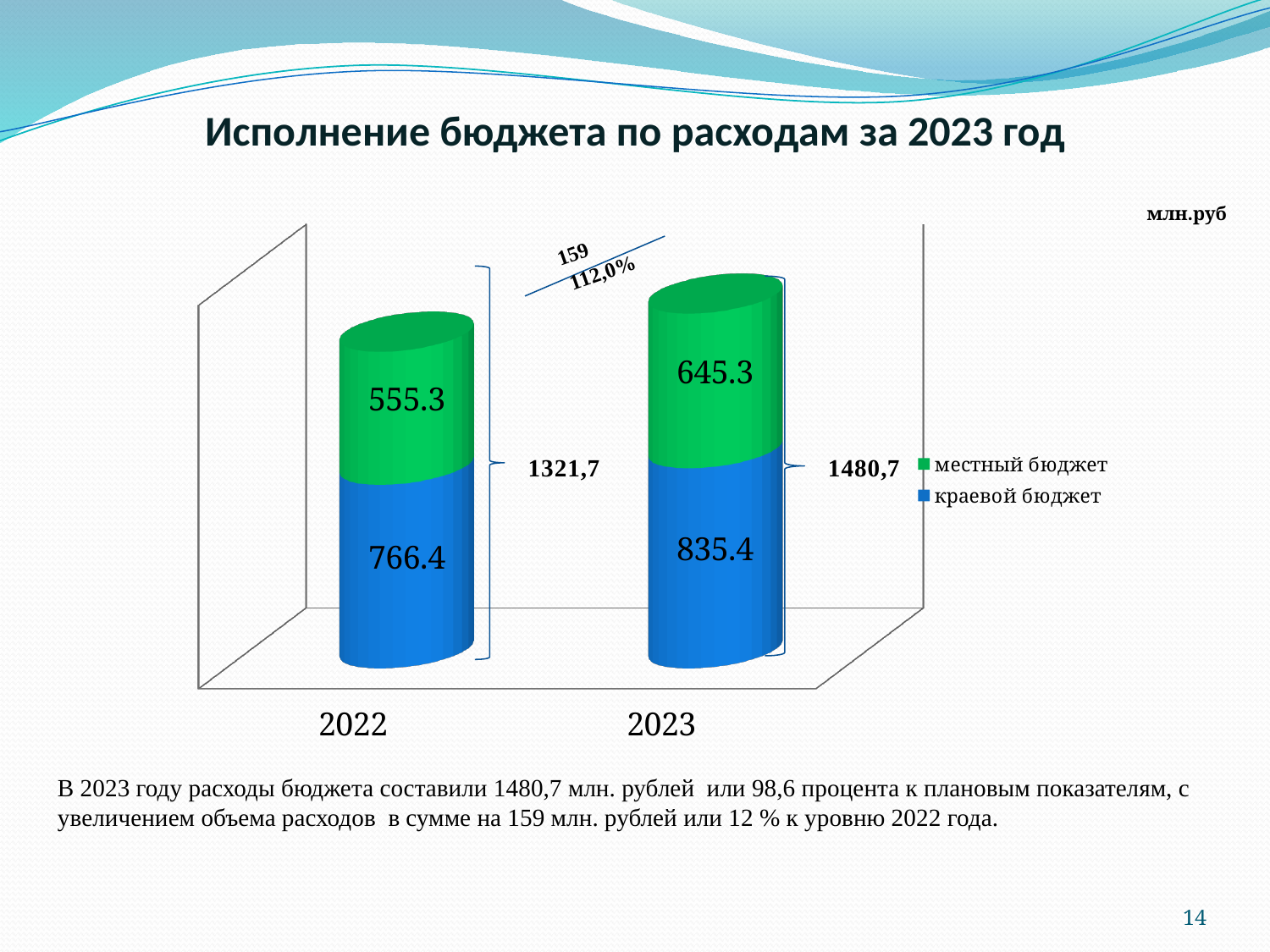
Which is larger in 2023: местный бюджет or краевой бюджет? краевой бюджет What is the difference between the краевой бюджет values for 2023 and 2022? 69.0 What is the value for местный бюджет in 2022? 555.3 What is the value for краевой бюджет in 2022? 766.4 What is the value for местный бюджет in 2023? 645.3 What is the total of the stacked bar for 2022? 1321,7 What is the value for краевой бюджет in 2023? 835.4 How many categories (years) are shown on the x axis? 2 What kind of chart is shown on the slide? stacked bar chart How many series does the legend list? 2 What is the difference between the местный бюджет values for 2023 and 2022? 90.0 What is the total of the stacked bar for 2023? 1480,7